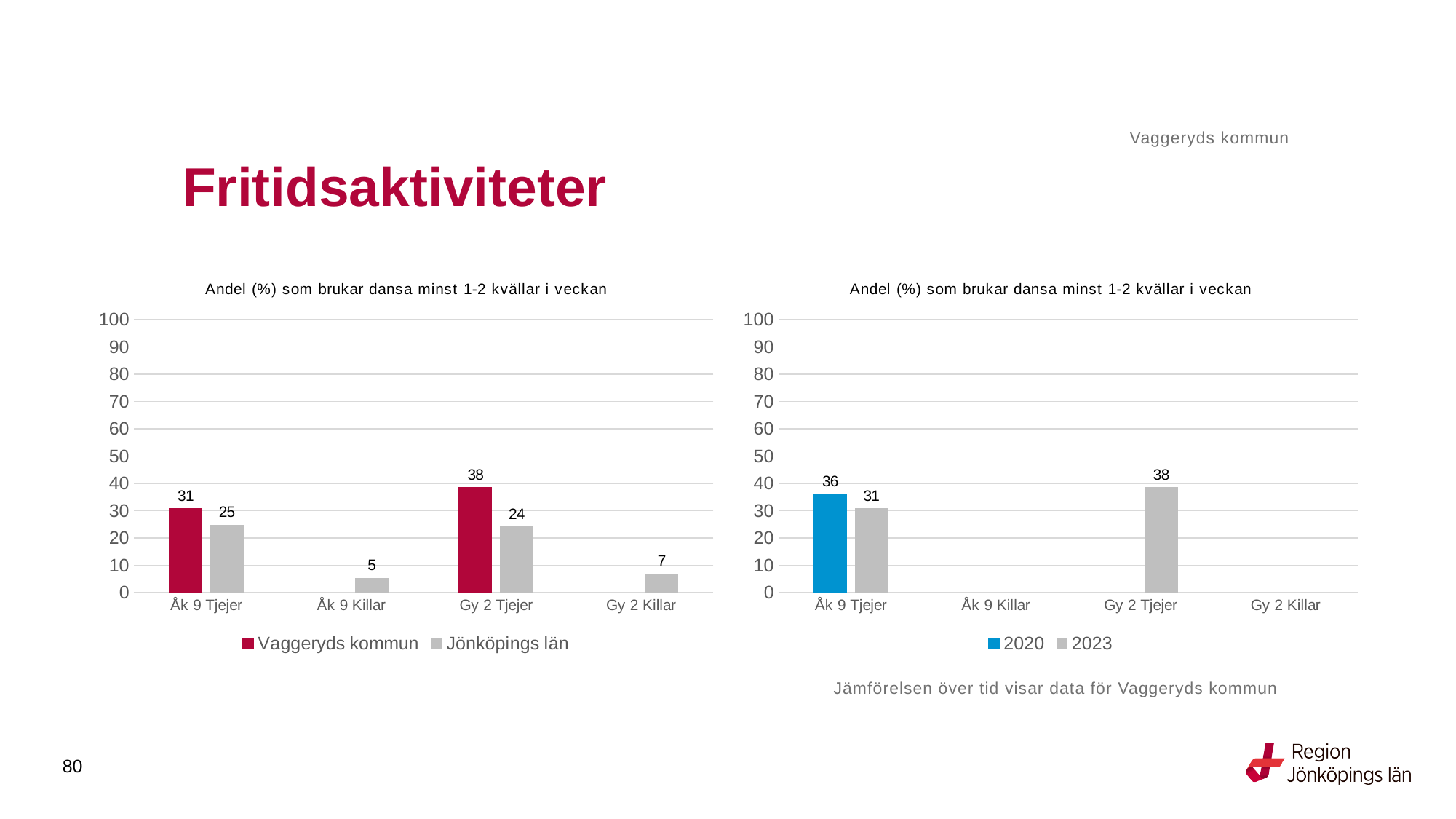
In the left chart, which is larger for Åk 9 Tjejer: Vaggeryds kommun or Jönköpings län? Vaggeryds kommun In the right chart, what is the value for 2020 for Åk 9 Tjejer? 36 How many series does the legend of the left chart list? 2 How many categories are shown on the x axis of the right chart? 4 In the left chart, what is the value for Jönköpings län for Gy 2 Tjejer? 24 What kind of chart is the right chart? Bar chart In the left chart, what is the value for Jönköpings län for Åk 9 Killar? 5 In the left chart, what is the value for Vaggeryds kommun for Åk 9 Tjejer? 31 In the left chart, what is the difference between Vaggeryds kommun and Jönköpings län for Gy 2 Tjejer? 14 In the left chart, which category has the lowest value for Jönköpings län? Åk 9 Killar In the right chart, what is the difference between 2020 and 2023 for Åk 9 Tjejer? 5 In the right chart, what is the value for 2023 for Gy 2 Tjejer? 38